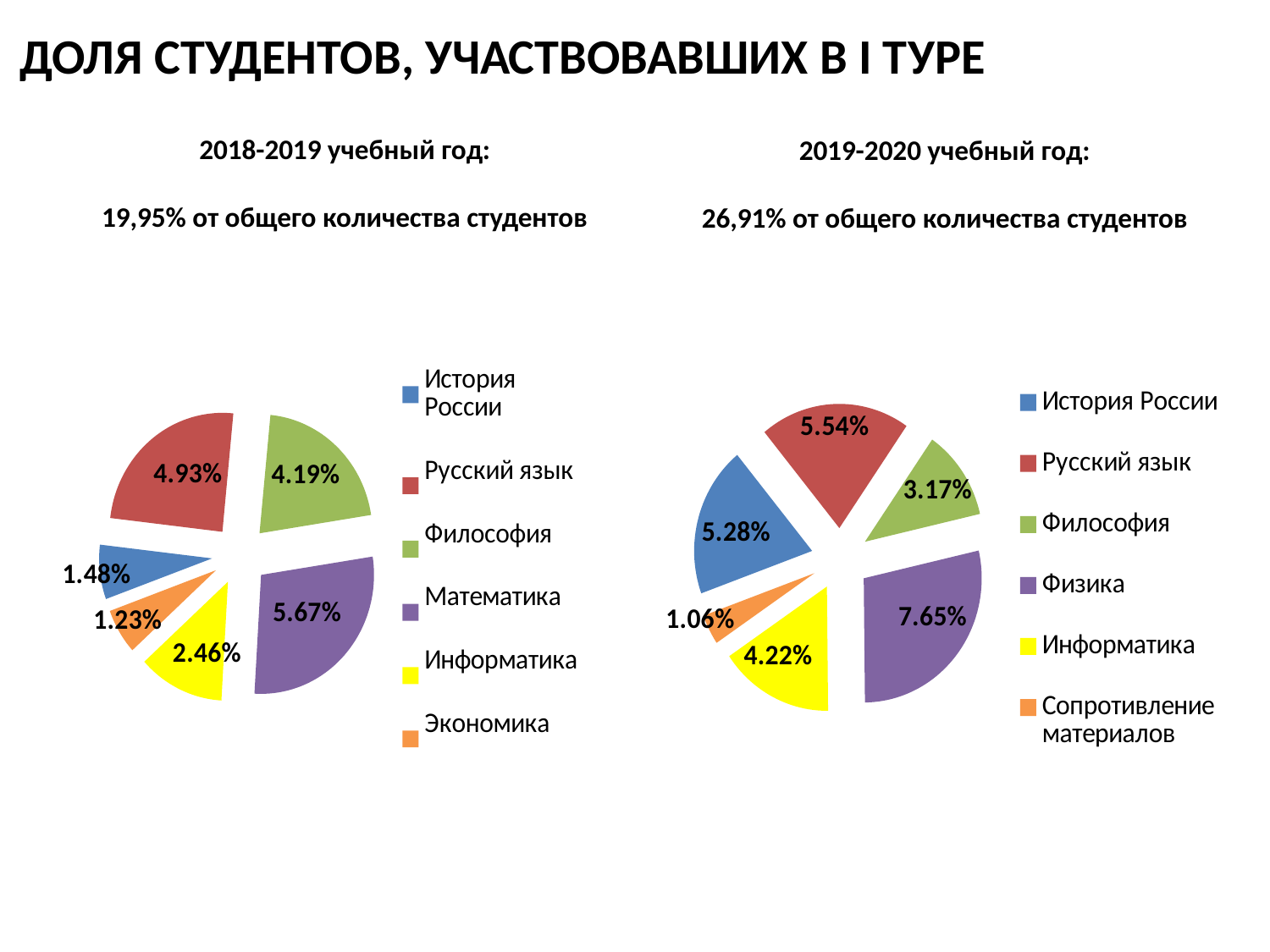
What is the difference between the values for Русский язык and Философия in the 2018-2019 chart? 0.74% How many categories does the 2019-2020 chart show? 6 In the 2019-2020 chart, which category has the smallest value? Сопротивление материалов In the 2018-2019 chart, what value is shown for Математика? 5.67% In the 2019-2020 chart, which is larger: Информатика or Философия? Информатика In the 2019-2020 chart, what value is shown for Сопротивление материалов? 1.06% What type of chart is used for the 2018-2019 data? Pie chart In the 2018-2019 chart, what value is shown for Экономика? 1.23% In the 2018-2019 chart, which category has the smallest value? Экономика In the 2019-2020 chart, what value is shown for Физика? 7.65% In the 2018-2019 chart, which category has the largest value? Математика Which category appears in the 2019-2020 chart legend but not in the 2018-2019 chart legend, besides Сопротивление материалов? Физика